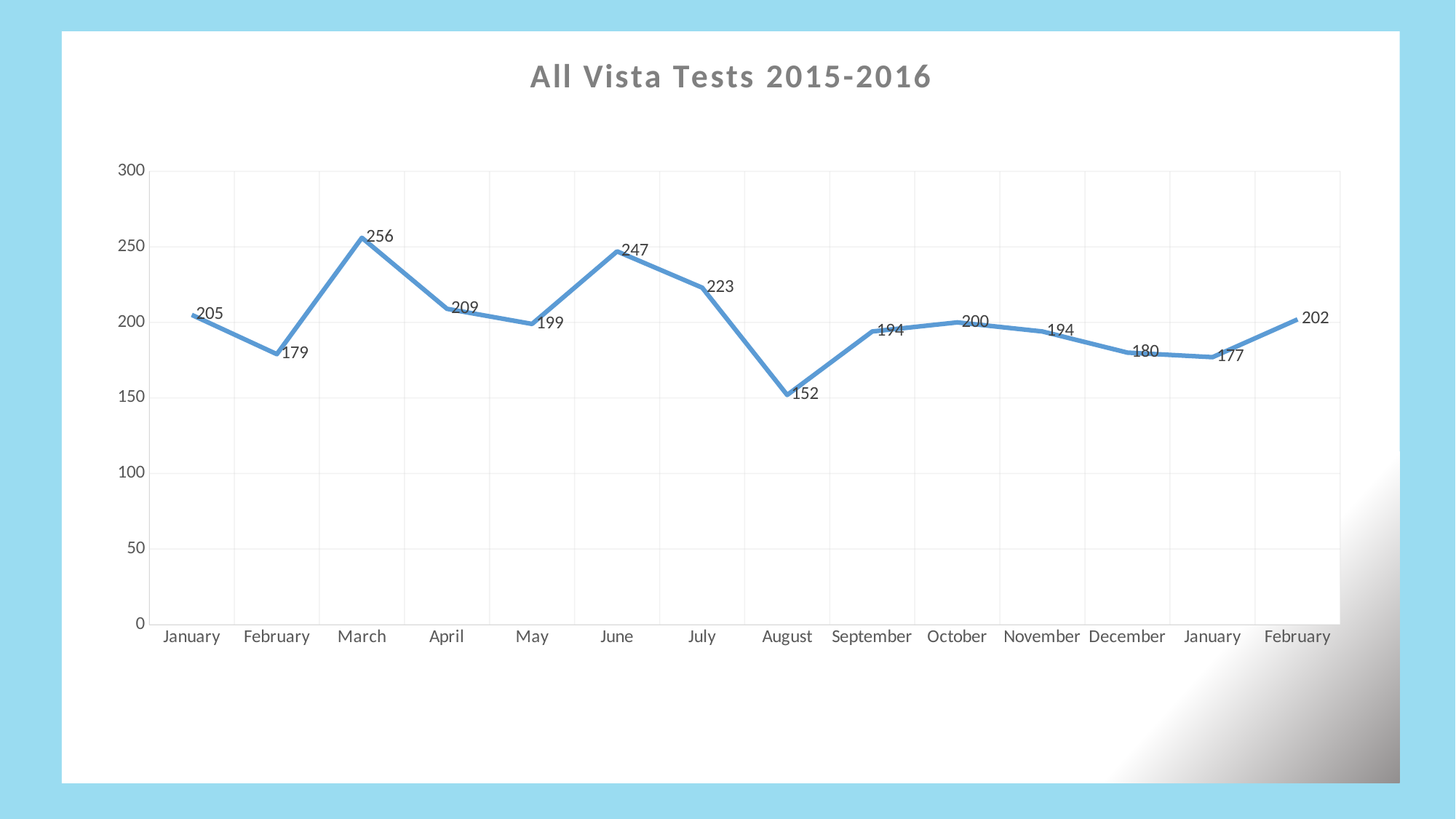
Which month has the lowest value? August What is the value for August? 152 What is the difference between the values for March and August? 104 What is the value for the first January on the chart? 205 Is the value for October greater or less than 150? greater What is the title of the chart? All Vista Tests 2015-2016 Which is larger, the value for June or the value for July? June What is the value for March? 256 Does the value rise or fall from July to August? Fall How many data points are plotted on the chart? 14 What kind of chart is shown? Line chart Which month has the highest value? March